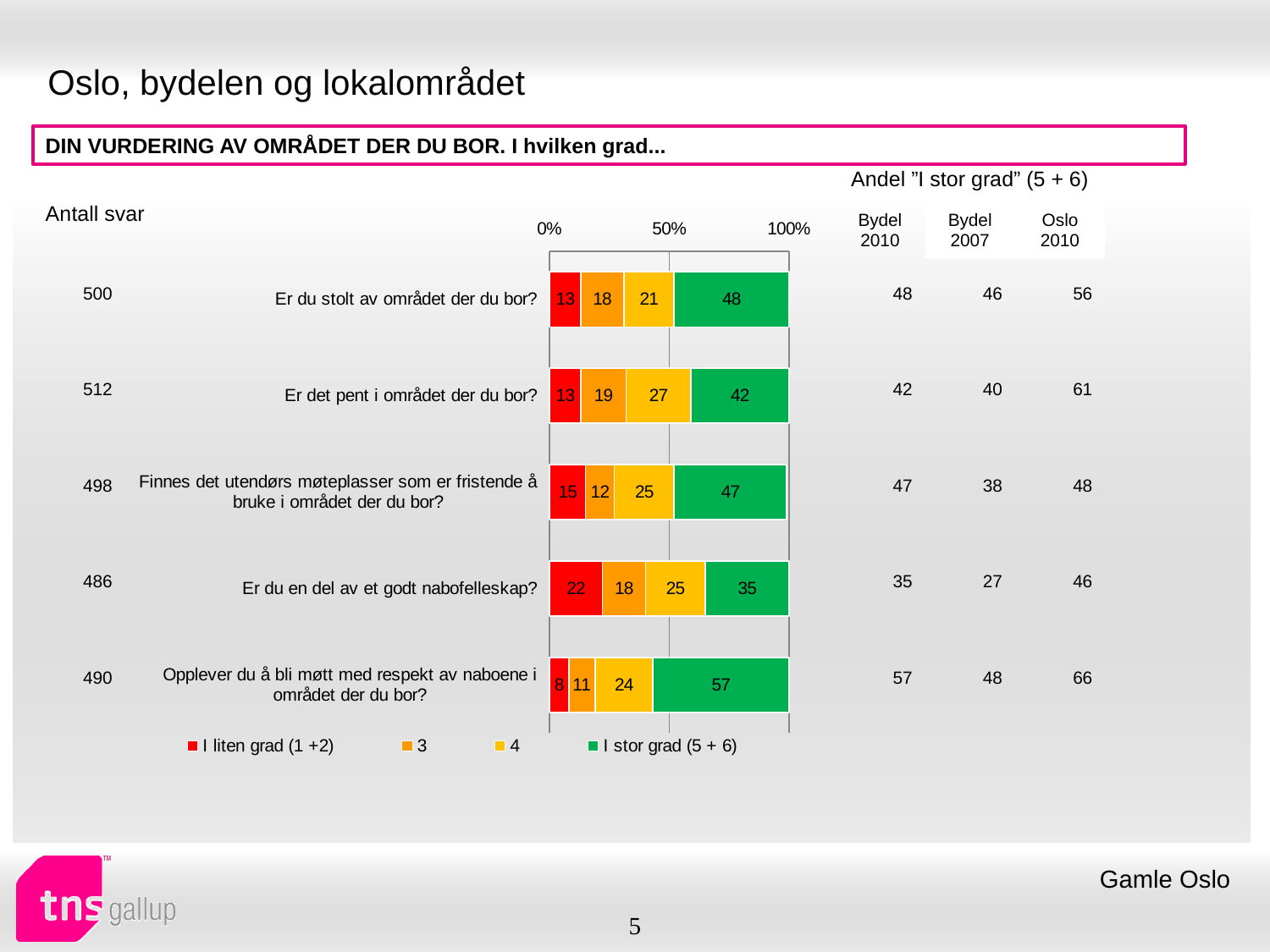
How many series does the legend list? 4 What is the value of "I stor grad (5 + 6)" for "Er du stolt av området der du bor?"? 48 What is the value of "I liten grad (1 +2)" for "Er du en del av et godt nabofelleskap?"? 22 What is the value of series "4" for "Er det pent i området der du bor?"? 27 Which is larger: the "3" value for "Er det pent i området der du bor?" or the "3" value for "Finnes det utendørs møteplasser som er fristende å bruke i området der du bor?"? Er det pent i området der du bor? What colour represents "I stor grad (5 + 6)" in the chart? green Which question has the highest value for "I stor grad (5 + 6)"? Opplever du å bli møtt med respekt av naboene i området der du bor? How many questions (categories) are plotted in the bar chart? 5 What is the total of the stacked bar for "Er det pent i området der du bor?"? 101 What is the difference between the "I stor grad (5 + 6)" values for "Opplever du å bli møtt med respekt av naboene i området der du bor?" and "Er du en del av et godt nabofelleskap?"? 22 Which question has the lowest value for "I liten grad (1 +2)"? Opplever du å bli møtt med respekt av naboene i området der du bor? What kind of chart is shown on the slide? stacked bar chart